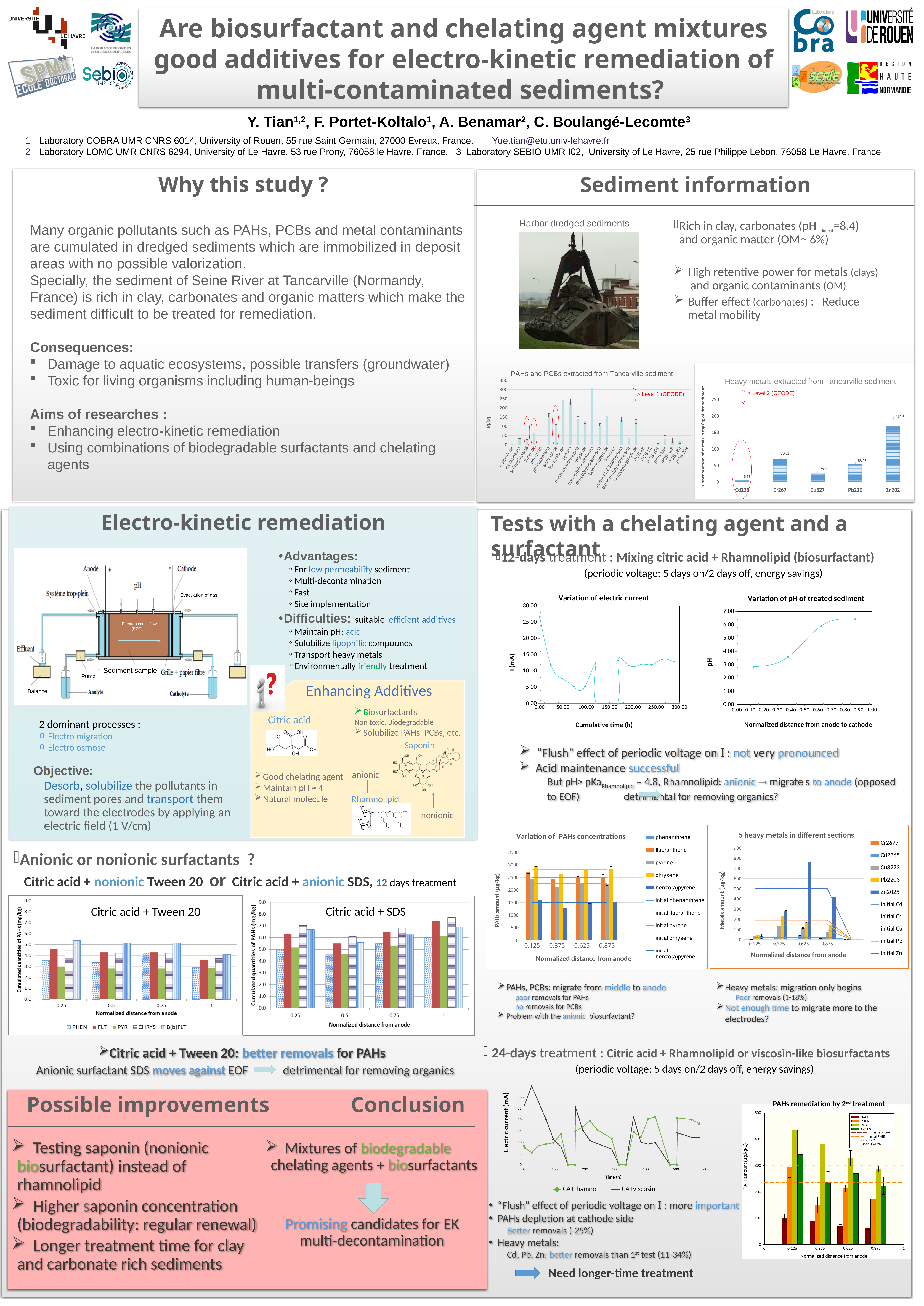
In the 'Heavy metals extracted from Tancarville sediment' chart, what is the concentration for Cd226? 6.23 What kind of chart is 'Heavy metals extracted from Tancarville sediment'? bar chart In the 'Heavy metals extracted from Tancarville sediment' chart, which metal has the lowest concentration? Cd226 In the 'Heavy metals extracted from Tancarville sediment' chart, what is the difference between the Cr267 and Pb220 values? 16.96 How many series does the legend list in the 'Citric acid + Tween 20' chart? 5 In the 'Citric acid + SDS' chart, is the CHRYS value at normalized distance 1 greater or less than 7.0? greater In the 'Heavy metals extracted from Tancarville sediment' chart, which metal has the highest concentration? Zn202 In the 'Heavy metals extracted from Tancarville sediment' chart, which is larger, Cu327 or Pb220? Pb220 How many metals are plotted in the 'Heavy metals extracted from Tancarville sediment' chart? 5 In the 'Heavy metals extracted from Tancarville sediment' chart, what is the concentration for Zn202? 169.6 In the 'Citric acid + Tween 20' chart, is the B(b)FLT value at normalized distance 0.25 greater or less than 5.0? greater How many series does the legend list in the 24-days electric current chart (CA+rhamno / CA+viscosin)? 2